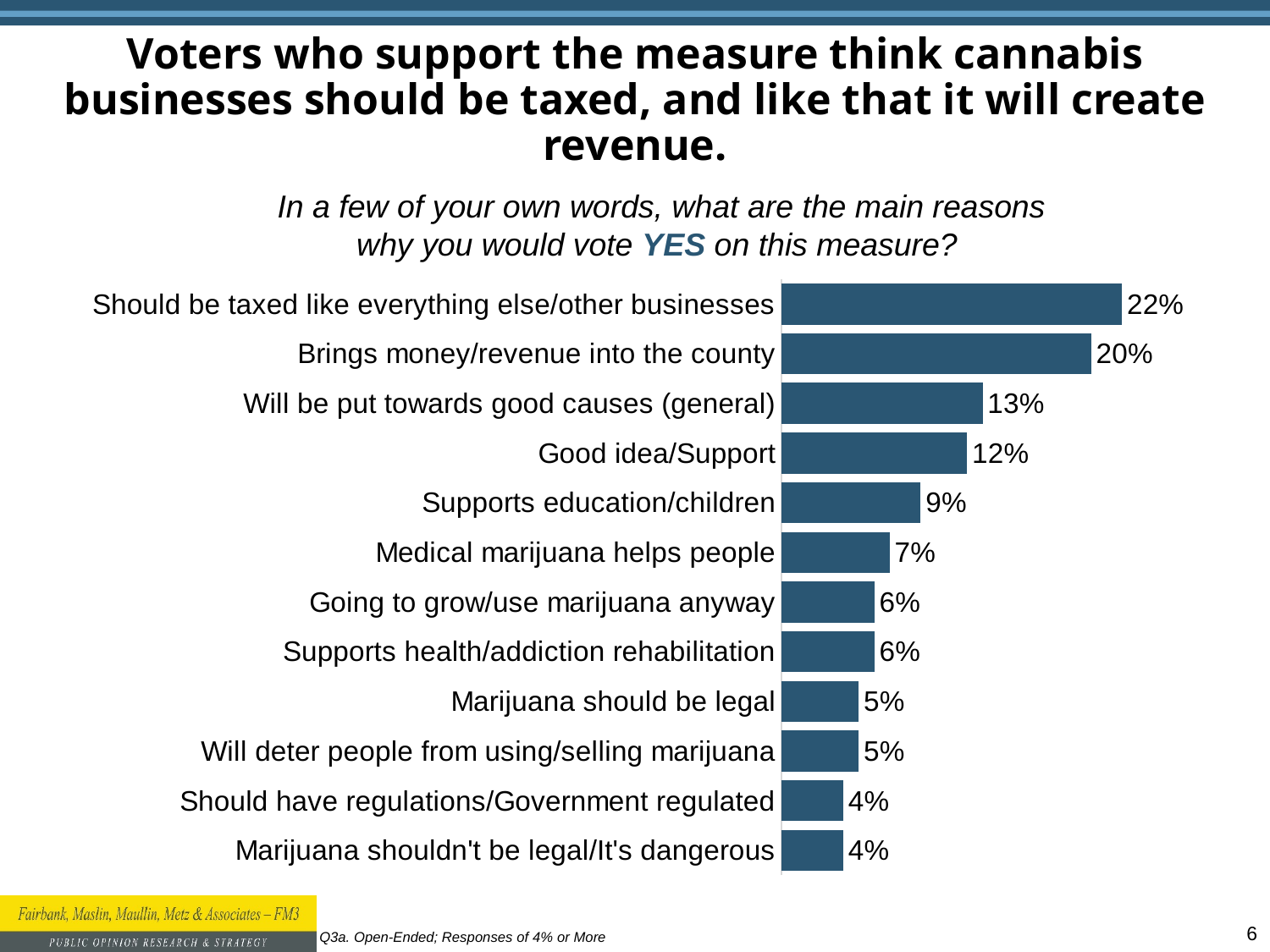
What percentage is shown for 'Supports education/children'? 9% What is the difference between 'Should be taxed like everything else/other businesses' and 'Brings money/revenue into the county'? 2% How many reasons are listed in the chart? 12 What is the value for 'Going to grow/use marijuana anyway'? 6% Which is larger: 'Good idea/Support' or 'Supports education/children'? Good idea/Support Which reason has the highest percentage? Should be taxed like everything else/other businesses What percentage of respondents said cannabis businesses should be taxed like everything else/other businesses? 22% What is the value for 'Brings money/revenue into the county'? 20% What is the difference between 'Will be put towards good causes (general)' and 'Marijuana should be legal'? 8% What is the lowest percentage shown in the chart? 4% What is the value for 'Medical marijuana helps people'? 7% What kind of chart is shown on the slide? Bar chart